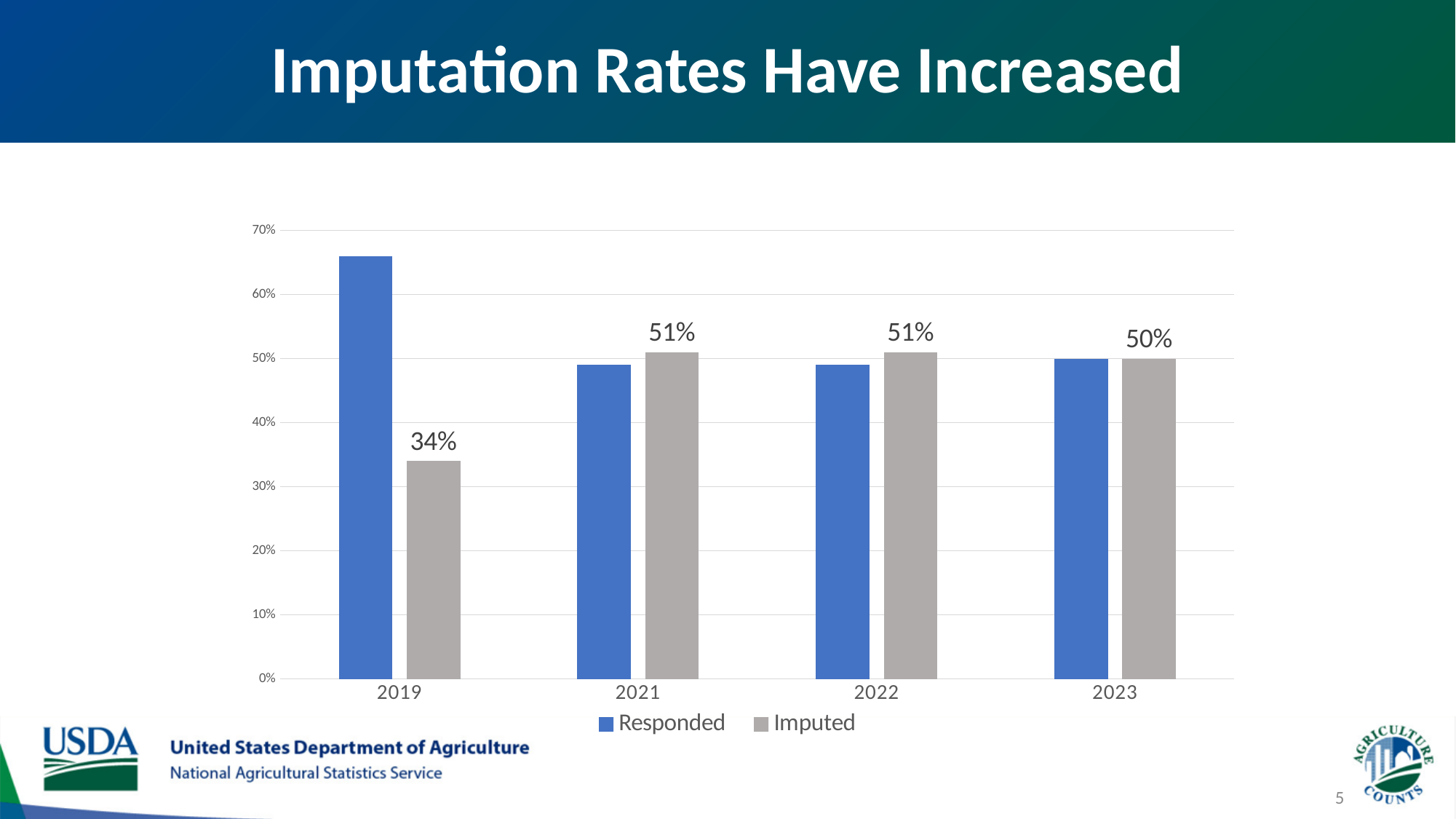
How many series does the legend list? 2 Is the Responded value for 2019 greater or less than 60%? greater Is the Responded value for 2021 greater or less than 40%? greater What is the difference between the Imputed values for 2021 and 2019? 17 percentage points What kind of chart is shown on the slide? bar chart What is the Imputed value for 2023? 50% What is the difference between the Imputed values for 2022 and 2023? 1 percentage point Which year has the lowest Imputed value? 2019 In 2019, which is larger, the Responded value or the Imputed value? Responded How many years are shown on the x axis? 4 What is the Imputed value for 2021? 51% What is the Imputed value for 2019? 34%